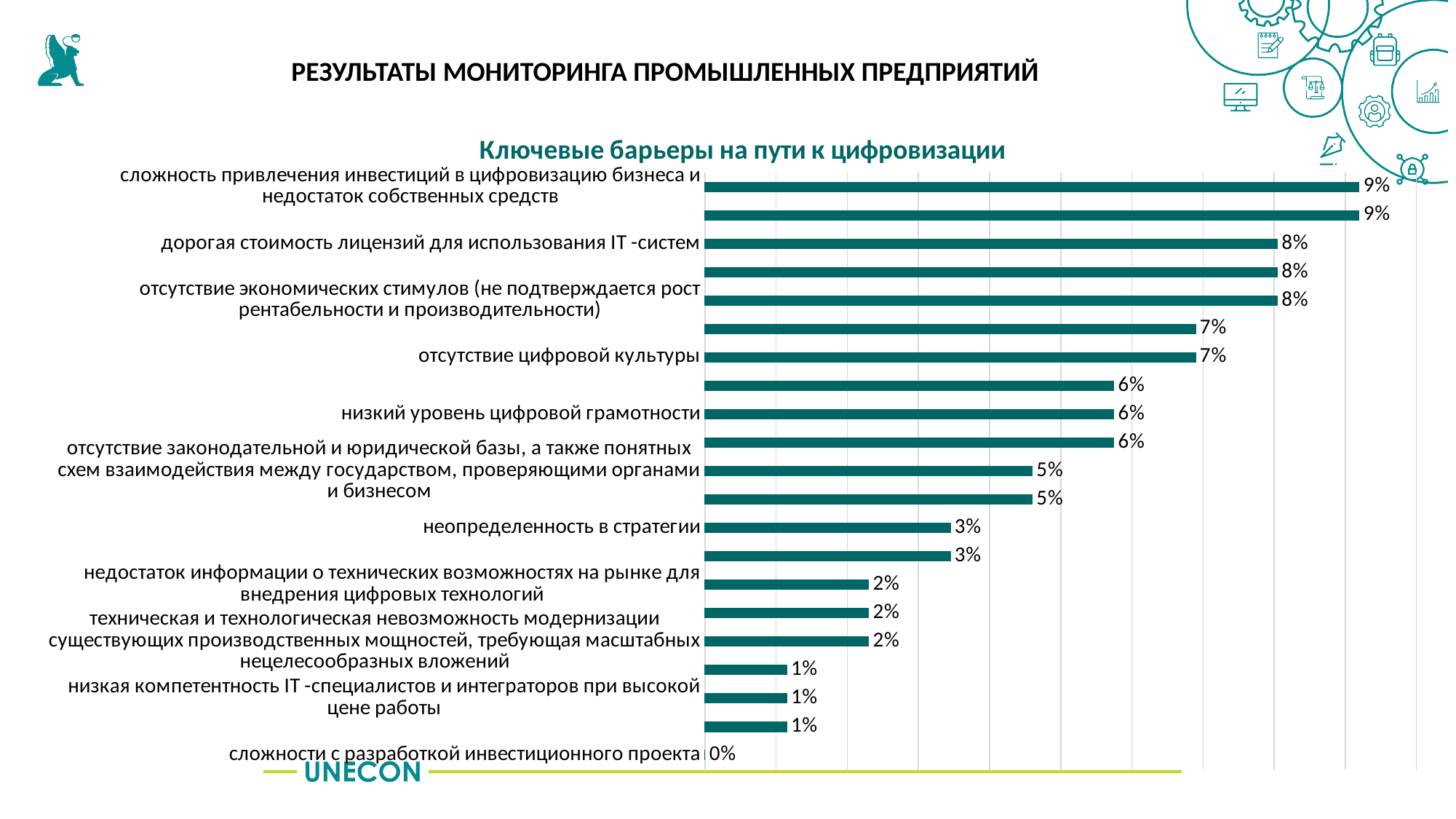
What is the value for 'сложности с разработкой инвестиционного проекта'? 0% Which category has the lowest value? сложности с разработкой инвестиционного проекта What type of chart is shown on the slide? bar chart Do the bar values increase or decrease from the top of the chart to the bottom? decrease What is the value for 'низкий уровень цифровой грамотности'? 6% What is the value for 'неопределенность в стратегии'? 3% Which is larger: the value for 'отсутствие цифровой культуры' or for 'неопределенность в стратегии'? отсутствие цифровой культуры What is the value for 'отсутствие цифровой культуры'? 7% What is the difference between the value for 'дорогая стоимость лицензий для использования IT-систем' and 'неопределенность в стратегии'? 5% What is the title of the chart? Ключевые барьеры на пути к цифровизации What is the value for 'дорогая стоимость лицензий для использования IT-систем'? 8% How many bars are plotted in the chart? 21